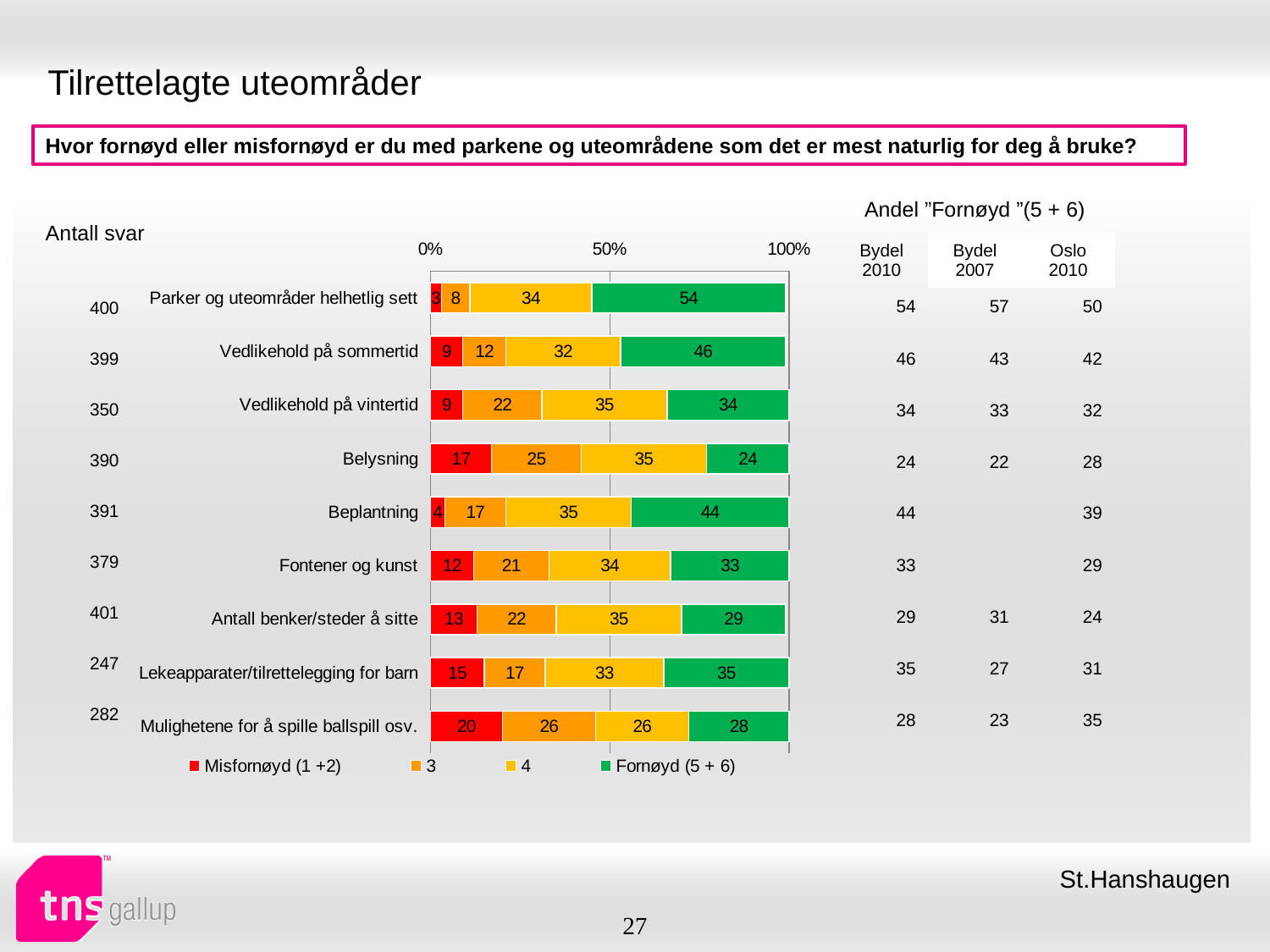
What kind of chart is shown on the slide? Stacked bar chart Which category has the highest "Misfornøyd (1 +2)" value? Mulighetene for å spille ballspill osv. Which category has the highest "Fornøyd (5 + 6)" value? Parker og uteområder helhetlig sett Which has a larger "Fornøyd (5 + 6)" value: "Beplantning" or "Fontener og kunst"? Beplantning What is the value of the "Fornøyd (5 + 6)" segment for "Parker og uteområder helhetlig sett"? 54 What is the difference between the "Fornøyd (5 + 6)" values for "Vedlikehold på sommertid" and "Vedlikehold på vintertid"? 12 How many categories are shown in the bar chart? 9 What is the value of the "3" segment for "Vedlikehold på vintertid"? 22 What is the value of the "Misfornøyd (1 +2)" segment for "Belysning"? 17 What is the total of the stacked bar for "Mulighetene for å spille ballspill osv."? 100 How many series does the chart legend list? 4 Which category has the lowest "Fornøyd (5 + 6)" value? Belysning